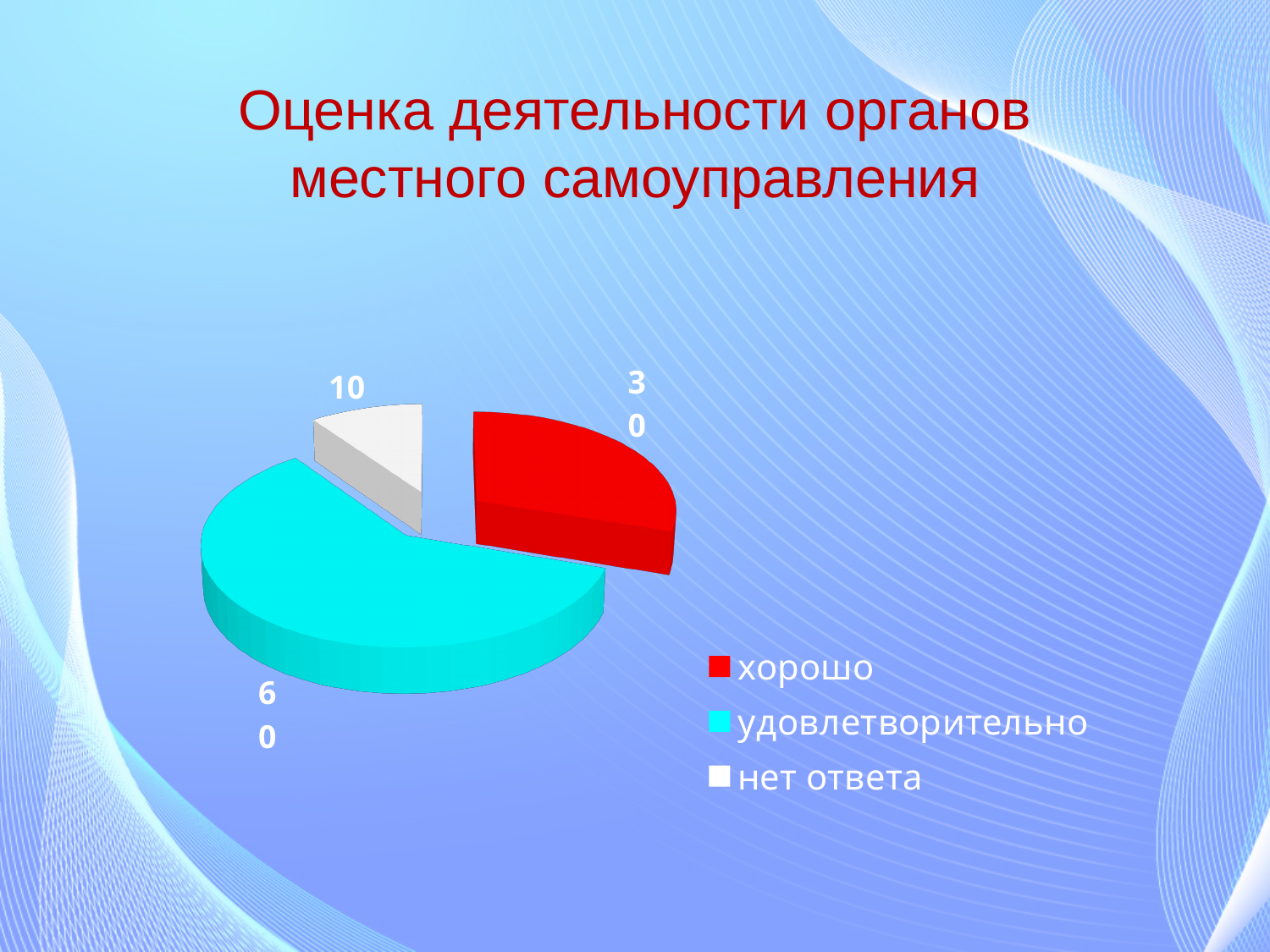
What is the difference between the values for "удовлетворительно" and "хорошо"? 30 What is the value for "нет ответа"? 10 Which category has the smallest slice? нет ответа What share of the pie does "удовлетворительно" represent? 60% What is the value for "хорошо"? 30 What is the value for "удовлетворительно"? 60 What colour is the slice for "хорошо"? red Which category has the largest slice? удовлетворительно How many entries does the legend list? 3 What kind of chart is shown on the slide? pie chart How many slices does the pie chart have? 3 Which is larger, the value for "хорошо" or the value for "нет ответа"? хорошо